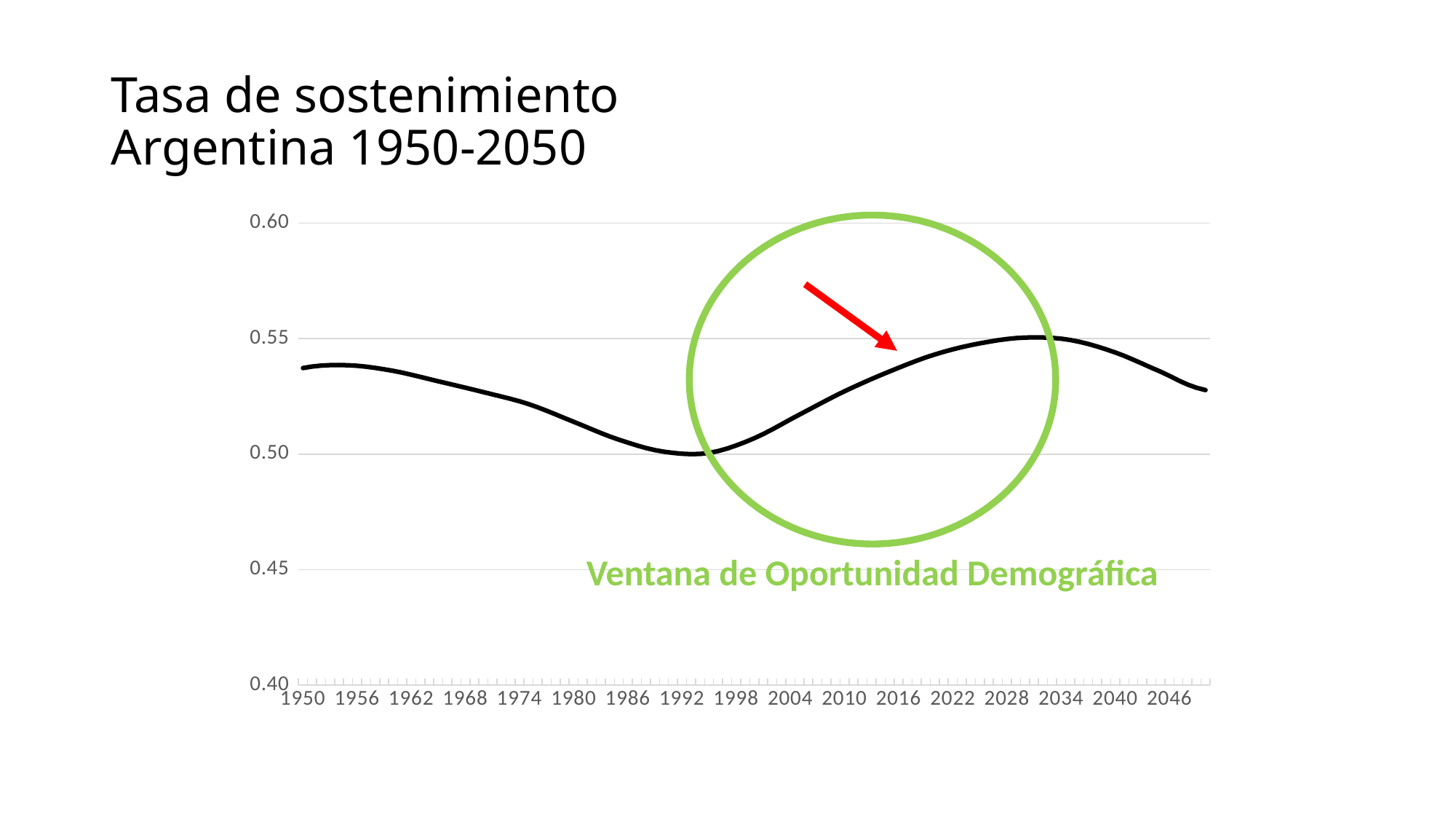
How many year labels are shown on the x axis? 17 Does the line rise or fall between 1998 and 2028? Rise Does the line rise or fall between 1950 and 1992? Fall Does the line rise or fall between 2034 and 2046? Fall What kind of chart is shown on the slide? Line chart Is the value for 2046 greater or less than 0.55? less Between which two labelled years does the line reach its lowest point? 1992 and 1998 Is the value for 2010 greater or less than 0.50? greater Is the value for 1950 greater or less than 0.50? greater What is the title of the chart on the slide? Tasa de sostenimiento Argentina 1950-2050 What text labels the green circle on the chart? Ventana de Oportunidad Demográfica